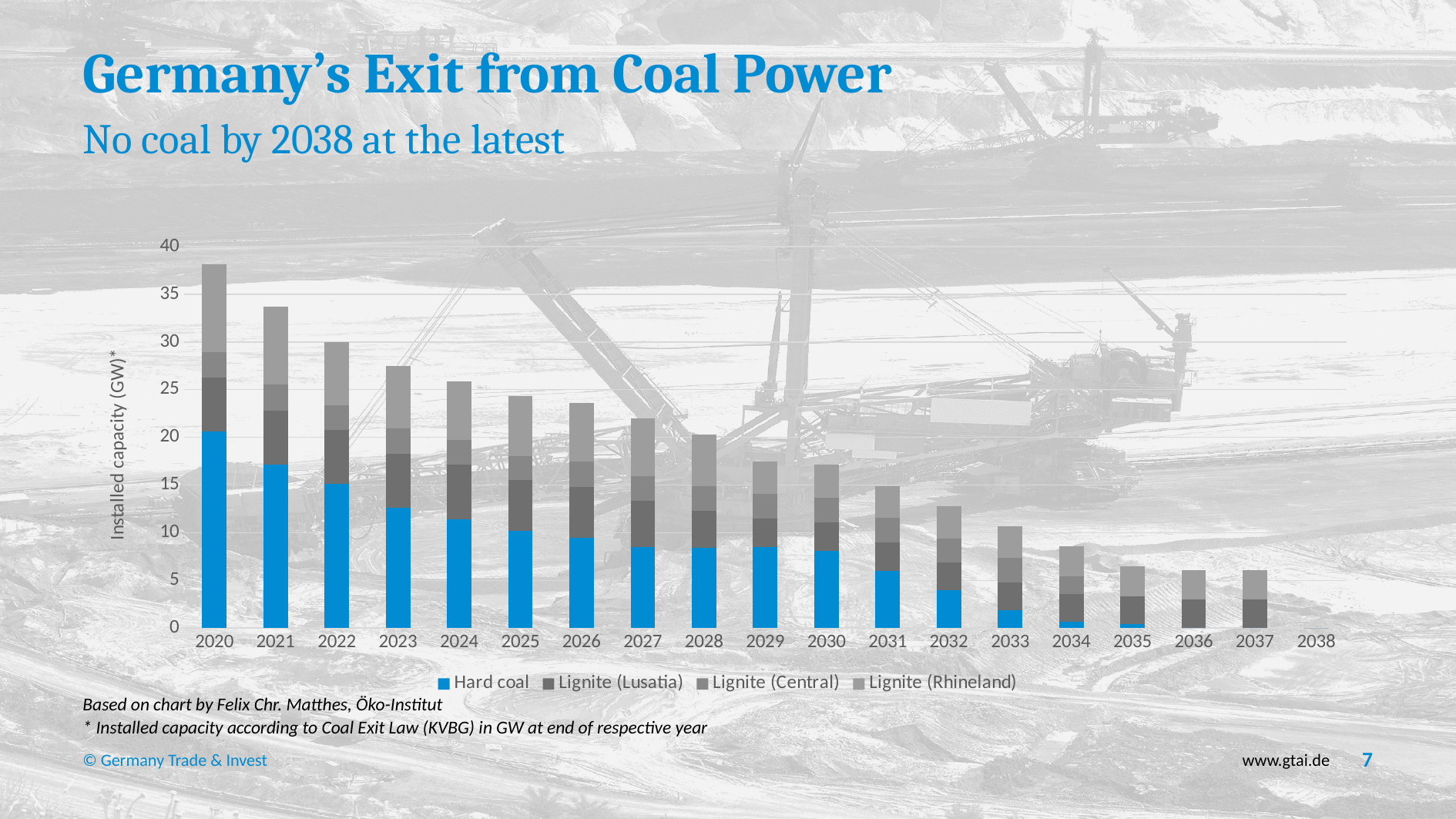
Is the total installed capacity for 2034 greater or less than 10? less How many year labels are shown on the x axis of the chart? 19 What is the label on the y axis of the chart? Installed capacity (GW)* Which year has the highest total installed capacity in the chart? 2020 Is the total installed capacity for 2027 greater or less than 20? greater Is the total installed capacity for 2021 greater or less than 35? less How many series does the chart legend list? 4 What kind of chart is shown on the slide? Stacked bar chart Does the total installed capacity rise or fall from 2020 to 2037? Fall Which is larger, the total installed capacity in 2020 or in 2030? 2020